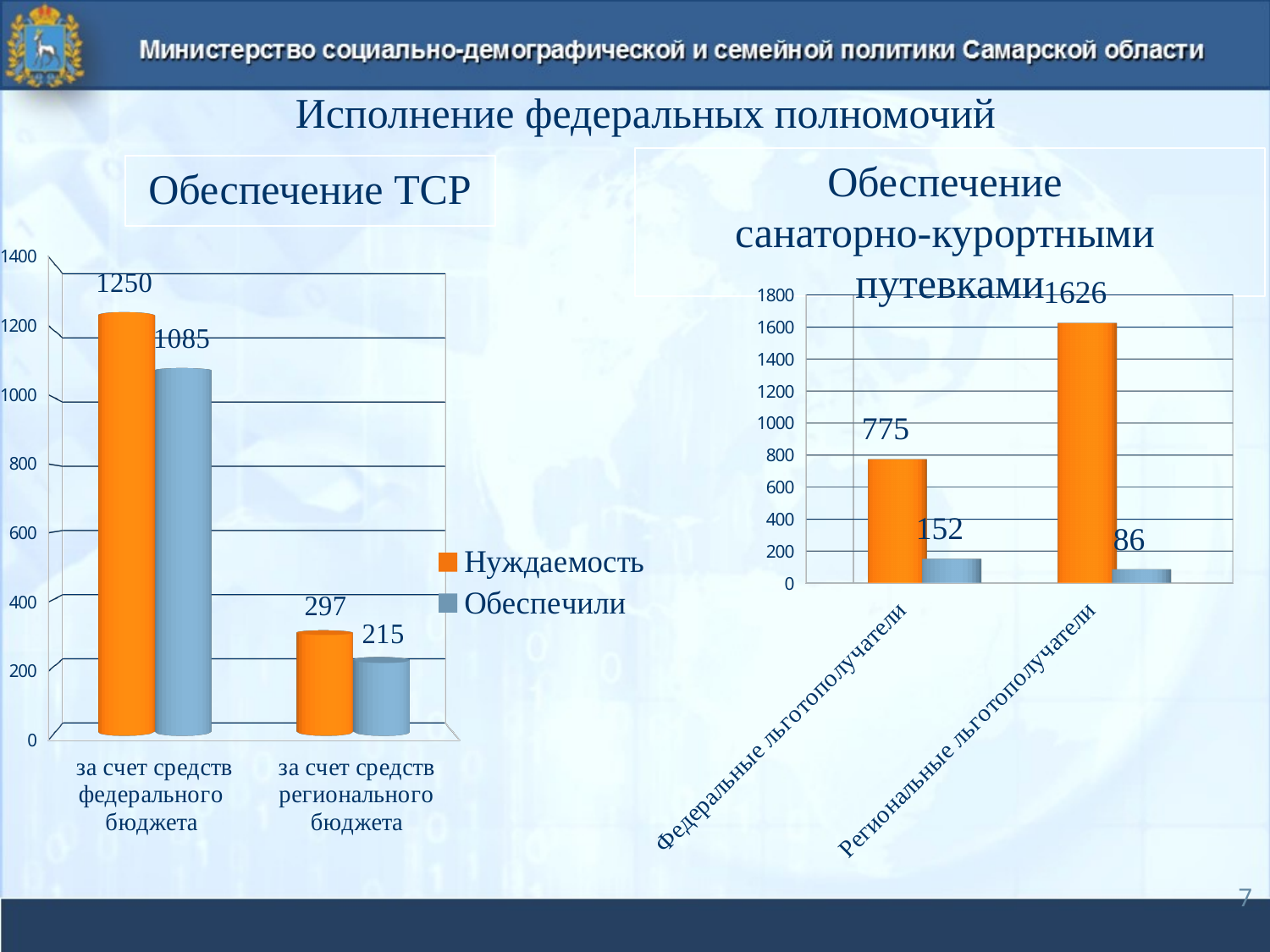
In the 'Обеспечение санаторно-курортными путевками' chart, what is the value of the blue bar for 'Федеральные льготополучатели'? 152 In the 'Обеспечение санаторно-курортными путевками' chart, which category has the lower blue bar value? Региональные льготополучатели How many categories are shown on the x axis of the 'Обеспечение санаторно-курортными путевками' chart? 2 In the 'Обеспечение ТСР' chart, what is the value of Обеспечили for 'за счет средств регионального бюджета'? 215 In the 'Обеспечение санаторно-курортными путевками' chart, what is the value of the orange bar for 'Региональные льготополучатели'? 1626 In the 'Обеспечение санаторно-курортными путевками' chart, what is the difference between the orange bars for 'Региональные льготополучатели' and 'Федеральные льготополучатели'? 851 In the 'Обеспечение ТСР' chart, which category has the higher Нуждаемость value? за счет средств федерального бюджета In the 'Обеспечение ТСР' chart, which series is shown in orange? Нуждаемость In the 'Обеспечение ТСР' chart, what is the difference between Нуждаемость and Обеспечили for 'за счет средств федерального бюджета'? 165 In the 'Обеспечение ТСР' chart, what is the value of Нуждаемость for 'за счет средств федерального бюджета'? 1250 In the 'Обеспечение ТСР' chart, how many series does the legend list? 2 What kind of chart is the 'Обеспечение санаторно-курортными путевками' chart? bar chart